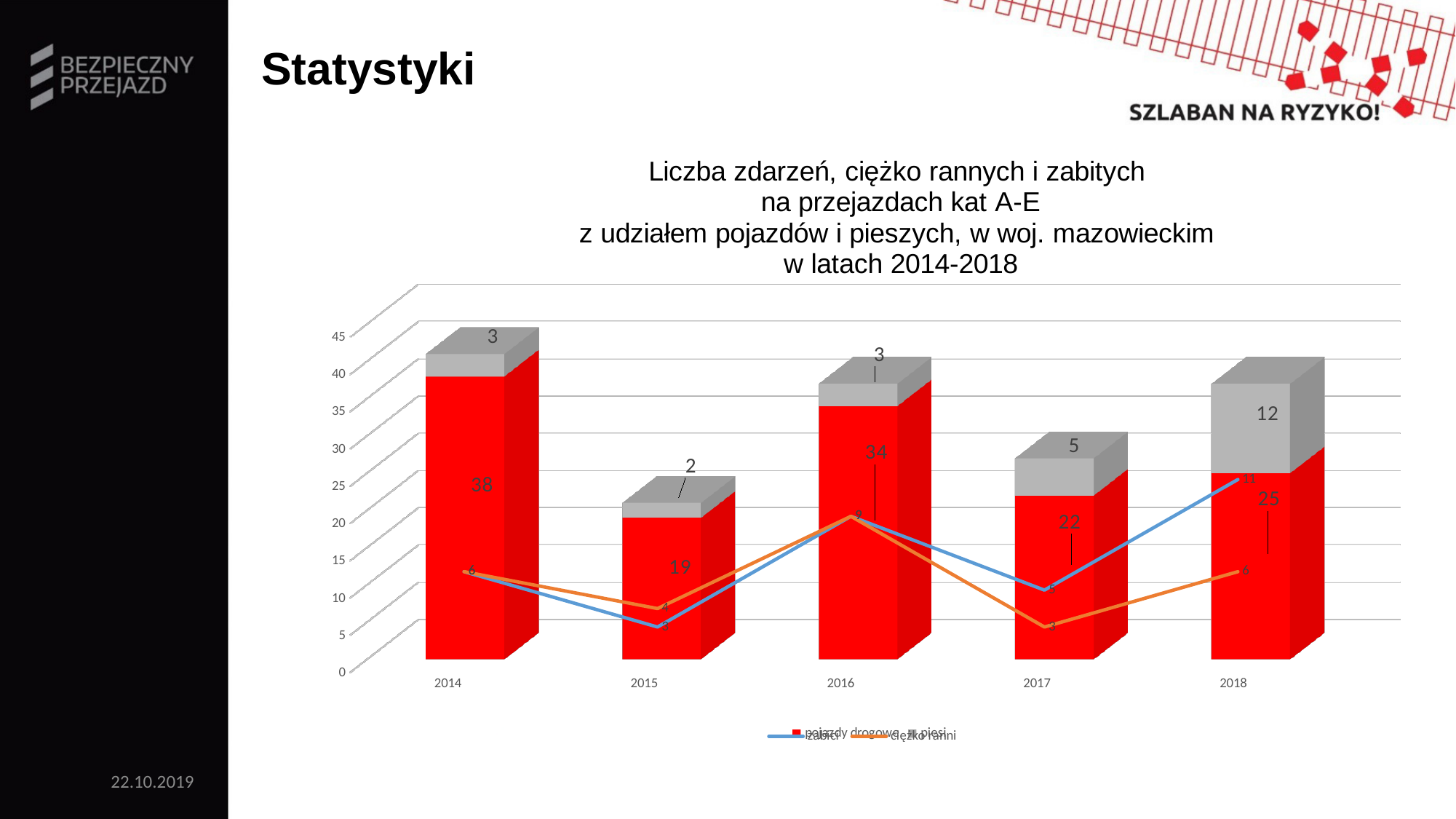
Which year has the highest value for pojazdy drogowe? 2014 What is the value for pojazdy drogowe in 2014? 38 Does the pojazdy drogowe value rise or fall from 2014 to 2015? fall Which year has the highest value for piesi? 2018 Which is larger, the pojazdy drogowe value for 2016 or for 2018? 2016 What is the total of the stacked bar for 2018? 37 What is the difference between the pojazdy drogowe values for 2014 and 2015? 19 What is the value for pojazdy drogowe in 2017? 22 What is the value for piesi in 2018? 12 What is the total of the stacked bar for 2014? 41 How many years are shown on the x axis? 5 Which year has the lowest value for pojazdy drogowe? 2015